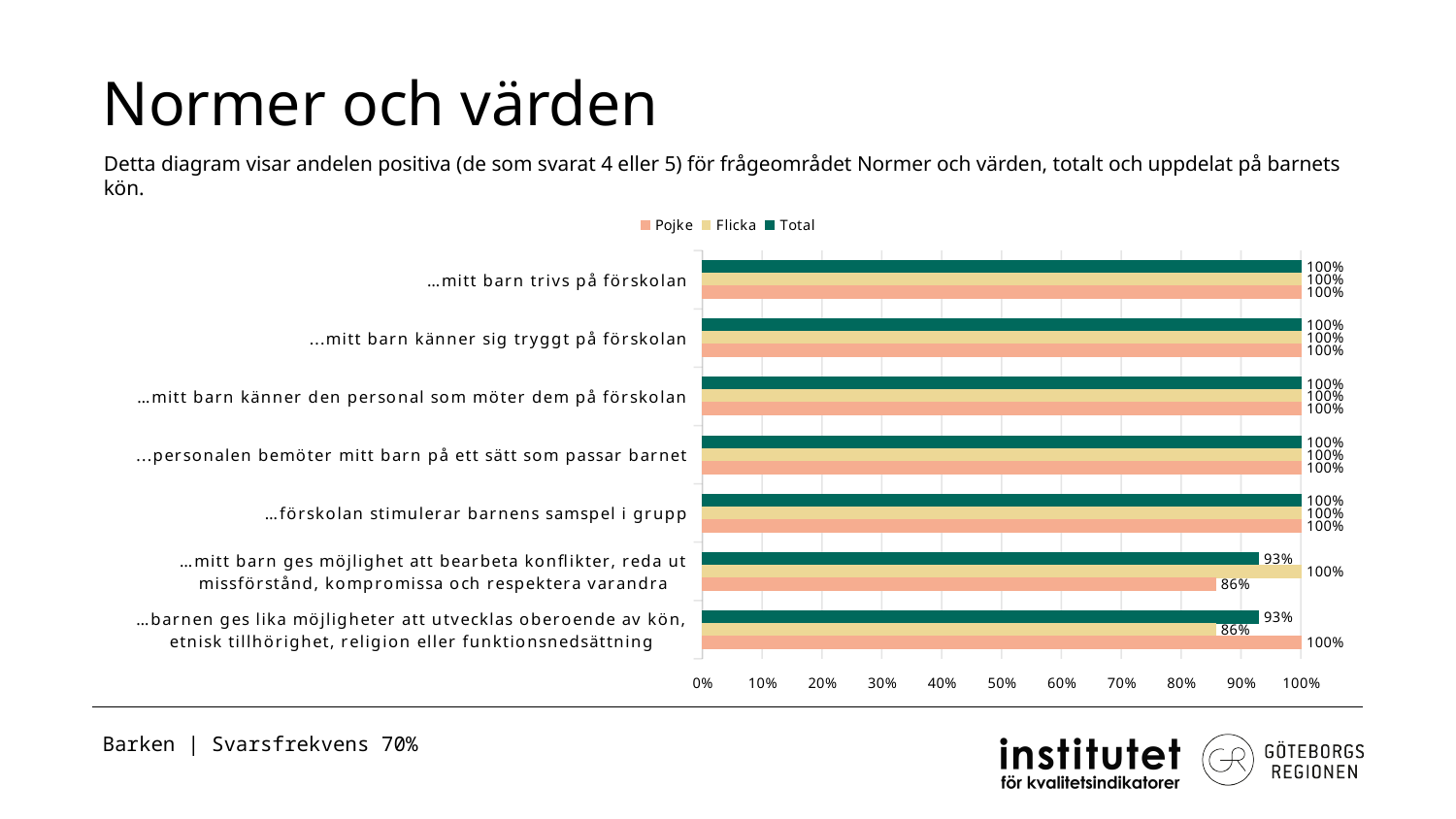
What is the Flicka value for "…barnen ges lika möjligheter att utvecklas oberoende av kön, etnisk tillhörighet, religion eller funktionsnedsättning"? 86% For "…barnen ges lika möjligheter att utvecklas oberoende av kön, etnisk tillhörighet, religion eller funktionsnedsättning", which is larger: the Pojke value or the Flicka value? Pojke What is the Total value for "…mitt barn trivs på förskolan"? 100% Which series has the lowest value for "…mitt barn ges möjlighet att bearbeta konflikter, reda ut missförstånd, kompromissa och respektera varandra"? Pojke What is the Total value for "…barnen ges lika möjligheter att utvecklas oberoende av kön, etnisk tillhörighet, religion eller funktionsnedsättning"? 93% How many categories (statements) are plotted on the chart? 7 Is the Pojke value for "…mitt barn ges möjlighet att bearbeta konflikter, reda ut missförstånd, kompromissa och respektera varandra" greater or less than 90%? less What is the difference between the Flicka and Pojke values for "…mitt barn ges möjlighet att bearbeta konflikter, reda ut missförstånd, kompromissa och respektera varandra"? 14% What kind of chart is shown on the slide? bar chart Which legend entry is shown in green? Total How many series does the legend list? 3 What is the Pojke value for "…mitt barn ges möjlighet att bearbeta konflikter, reda ut missförstånd, kompromissa och respektera varandra"? 86%